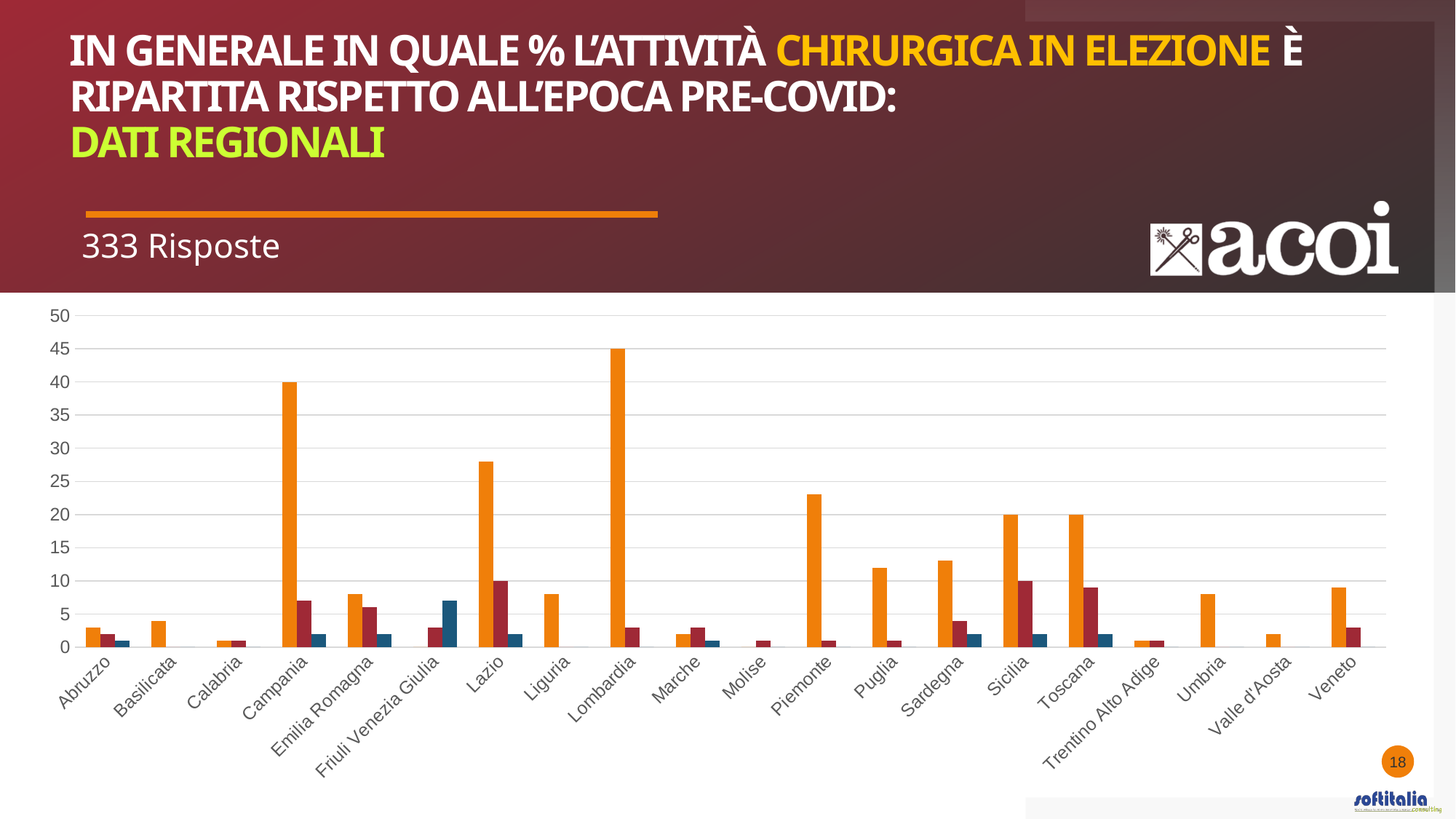
What is the value of the orange bar for Campania? 40 Which region has the tallest orange bar in the chart? Lombardia What is the value of the dark red bar for Lazio? 10 Is the orange bar for Lazio greater or less than 25? greater Is the orange bar for Piemonte greater or less than 20? greater What kind of chart is shown on the slide? bar chart How many regions are shown on the x axis of the chart? 20 How many responses does the slide say the chart is based on? 333 Risposte Which region has the larger orange bar, Campania or Lazio? Campania What is the value of the orange bar for Lombardia? 45 Is the dark blue bar for Friuli Venezia Giulia greater or less than 5? greater What is the difference between the orange bars for Lombardia and Campania? 5